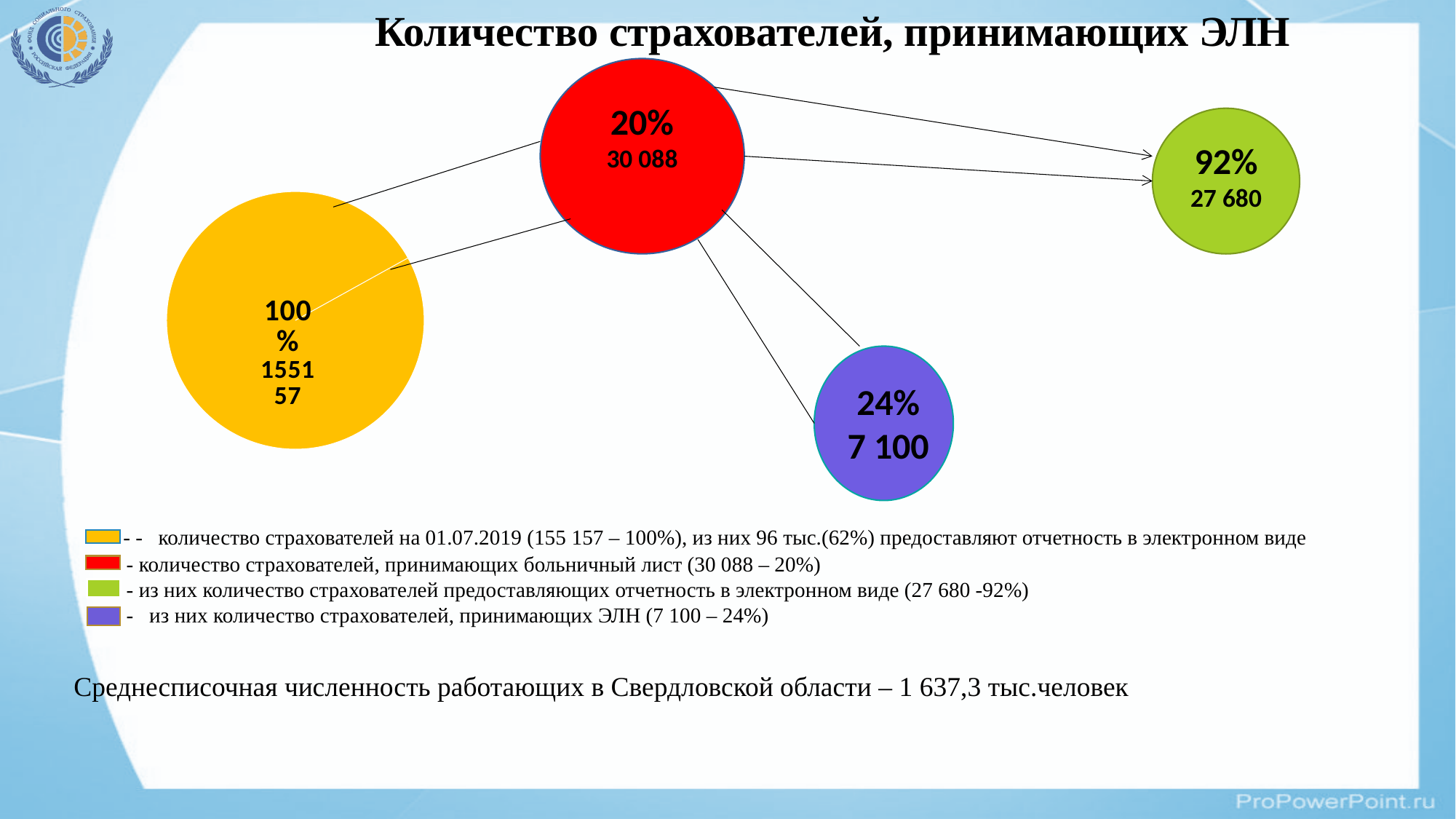
What is the title of the slide? Количество страхователей, принимающих ЭЛН What number is printed in the purple circle? 7 100 Which is larger, the number in the green circle or the number in the purple circle? the green circle (27 680) What is the difference between the number in the red circle and the number in the green circle? 2 408 How many circles are shown in the diagram? 4 Which circle shows the smallest number of insurers? the purple circle (7 100) Which circle shows the largest number of insurers? the yellow circle (155 157) What percentage is printed in the green circle? 92% What percentage is printed in the purple circle? 24% What number is printed in the red circle? 30 088 What is the difference between the number in the green circle and the number in the purple circle? 20 580 What percentage is printed in the yellow circle? 100%